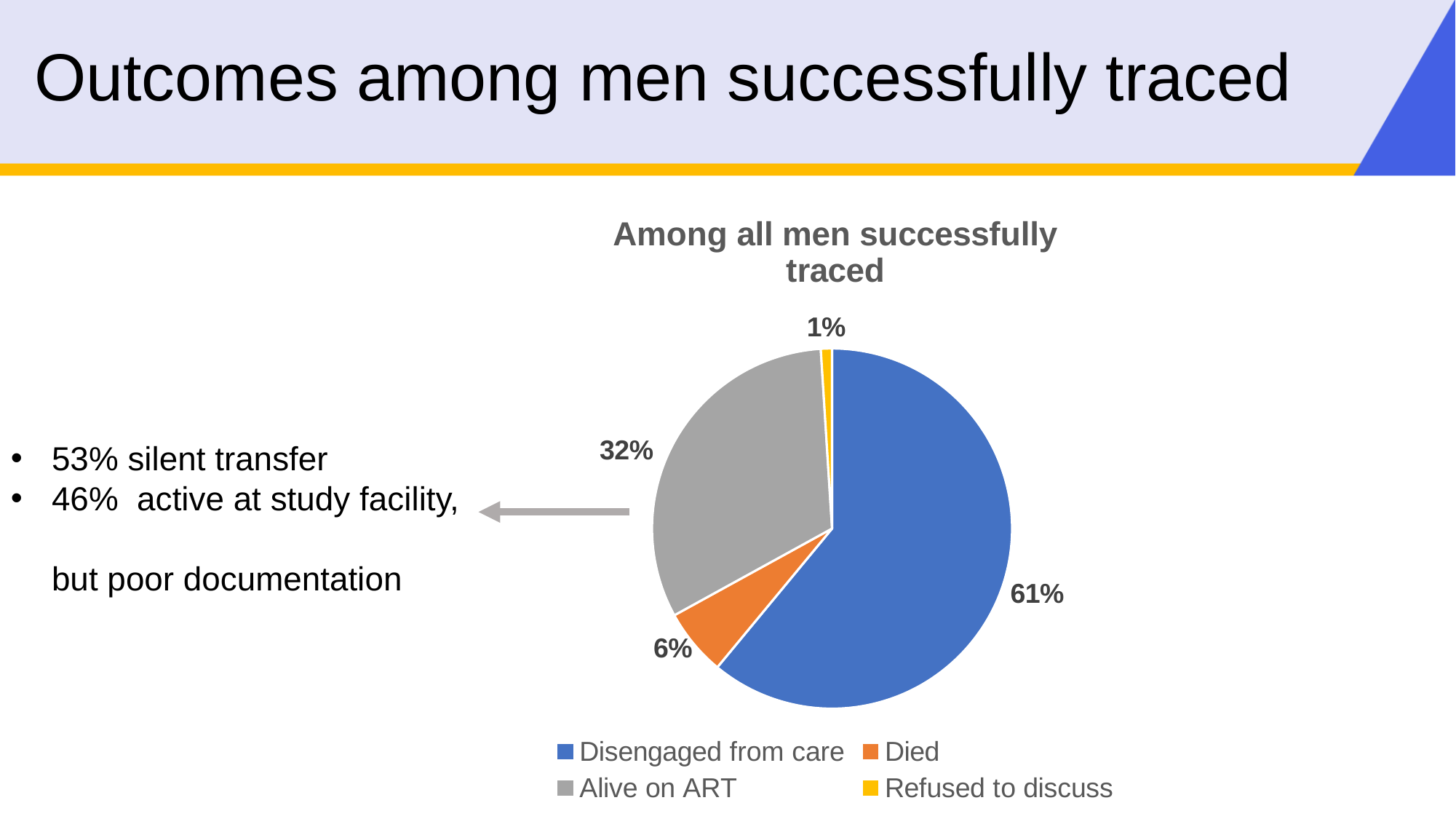
What percentage of men successfully traced died? 6% Which is larger, the share for Died or the share for Alive on ART? Alive on ART What colour represents Died in the pie chart? orange What percentage of men successfully traced refused to discuss? 1% What is the chart's title? Among all men successfully traced What is the difference in percentage points between Disengaged from care and Alive on ART? 29 What kind of chart is shown on the slide? pie chart Which category has the largest share of the pie? Disengaged from care Which category has the smallest share of the pie? Refused to discuss How many categories does the legend list? 4 What percentage of men successfully traced were disengaged from care? 61% What percentage of men successfully traced were alive on ART? 32%